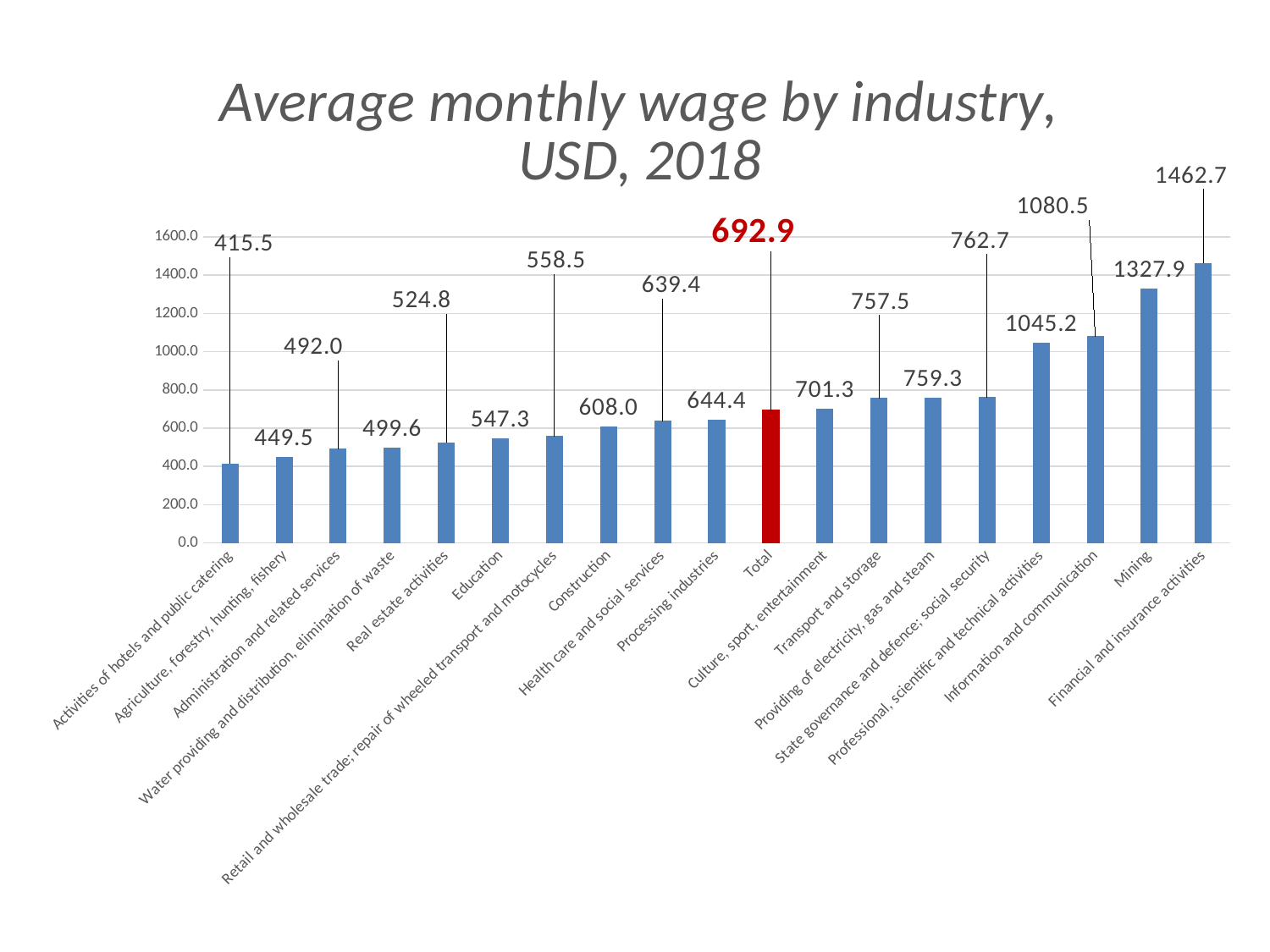
What kind of chart is shown on the slide? Bar chart Which is larger, the value for Construction or the value for Health care and social services? Health care and social services Is the value for Information and communication greater or less than 1000.0? greater What is the difference between the values for Financial and insurance activities and Mining? 134.8 Which industry has the lowest average monthly wage? Activities of hotels and public catering Do the values generally rise or fall from left to right along the x axis? Rise How many bars are plotted on the chart? 19 Which bar is coloured red instead of blue? Total Which industry has the highest average monthly wage? Financial and insurance activities What is the value of the red bar labelled Total? 692.9 What is the average monthly wage for Education? 547.3 What is the value shown for Mining? 1327.9